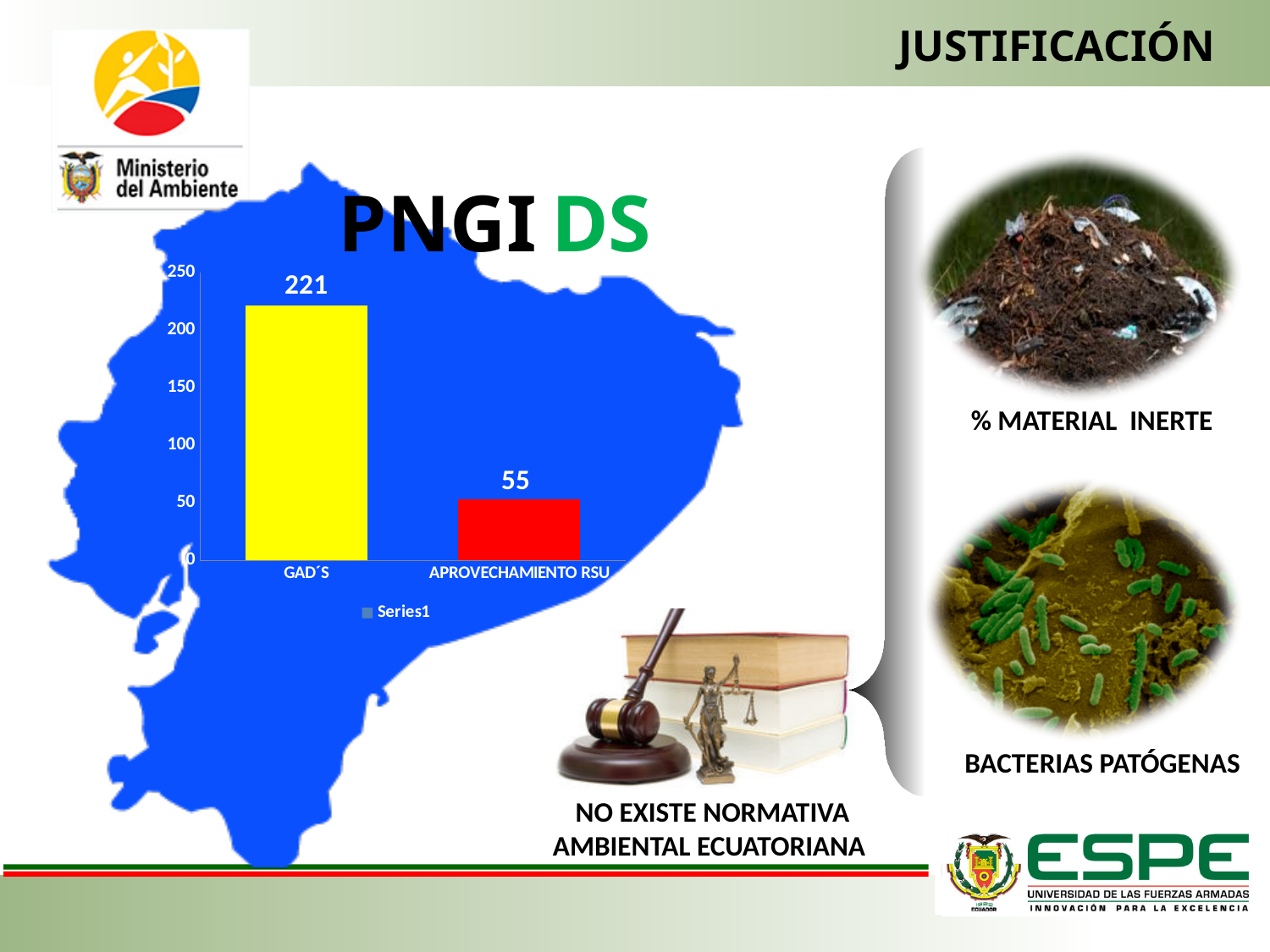
Which category has the highest value? GAD´S How many series does the legend list? 1 What kind of chart is shown on the slide? bar chart Which is larger, the value for GAD´S or the value for APROVECHAMIENTO RSU? GAD´S Which category has the lowest value? APROVECHAMIENTO RSU What is the value for APROVECHAMIENTO RSU? 55 Is the value for APROVECHAMIENTO RSU greater or less than 100? less What is the difference between the values for GAD´S and APROVECHAMIENTO RSU? 166 What colour is the bar for GAD´S? yellow How many categories are shown on the chart? 2 What is the value for GAD´S? 221 Is the value for GAD´S greater or less than 200? greater